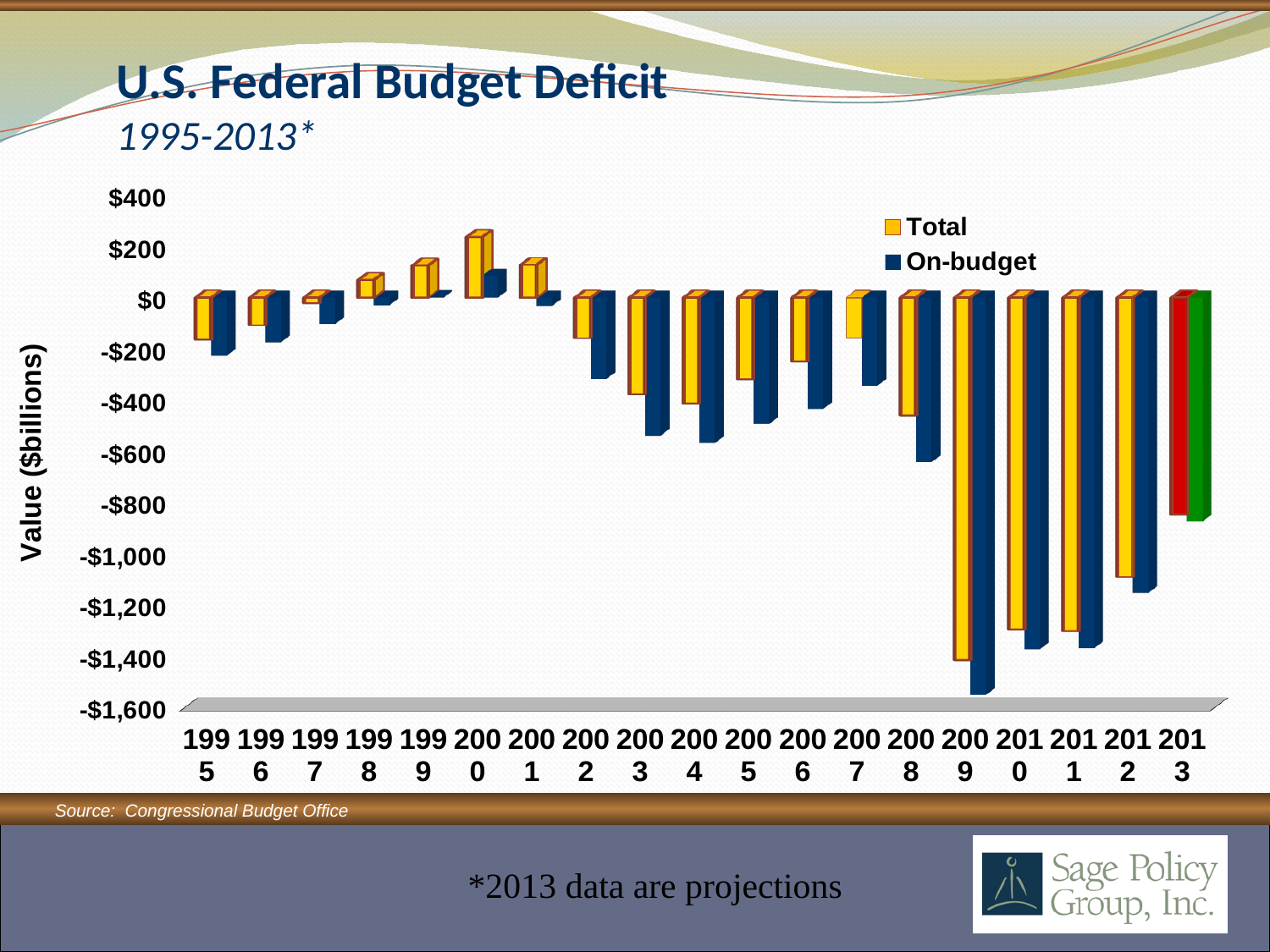
In which year is the Total value highest? 2000 In which year is the On-budget value lowest? 2009 Do the Total values rise or fall from 2007 to 2009? fall Which is larger, the On-budget value for 2000 or the On-budget value for 2001? 2000 How many years are shown along the x axis? 19 Is the On-budget value for 2004 greater or less than -$400? less Is the Total value for 2000 greater or less than $200? greater What kind of chart is shown on the slide? bar chart Is the On-budget value for 2009 greater or less than -$1,400? less What is the label on the y axis? Value ($billions) How many series does the legend list? 2